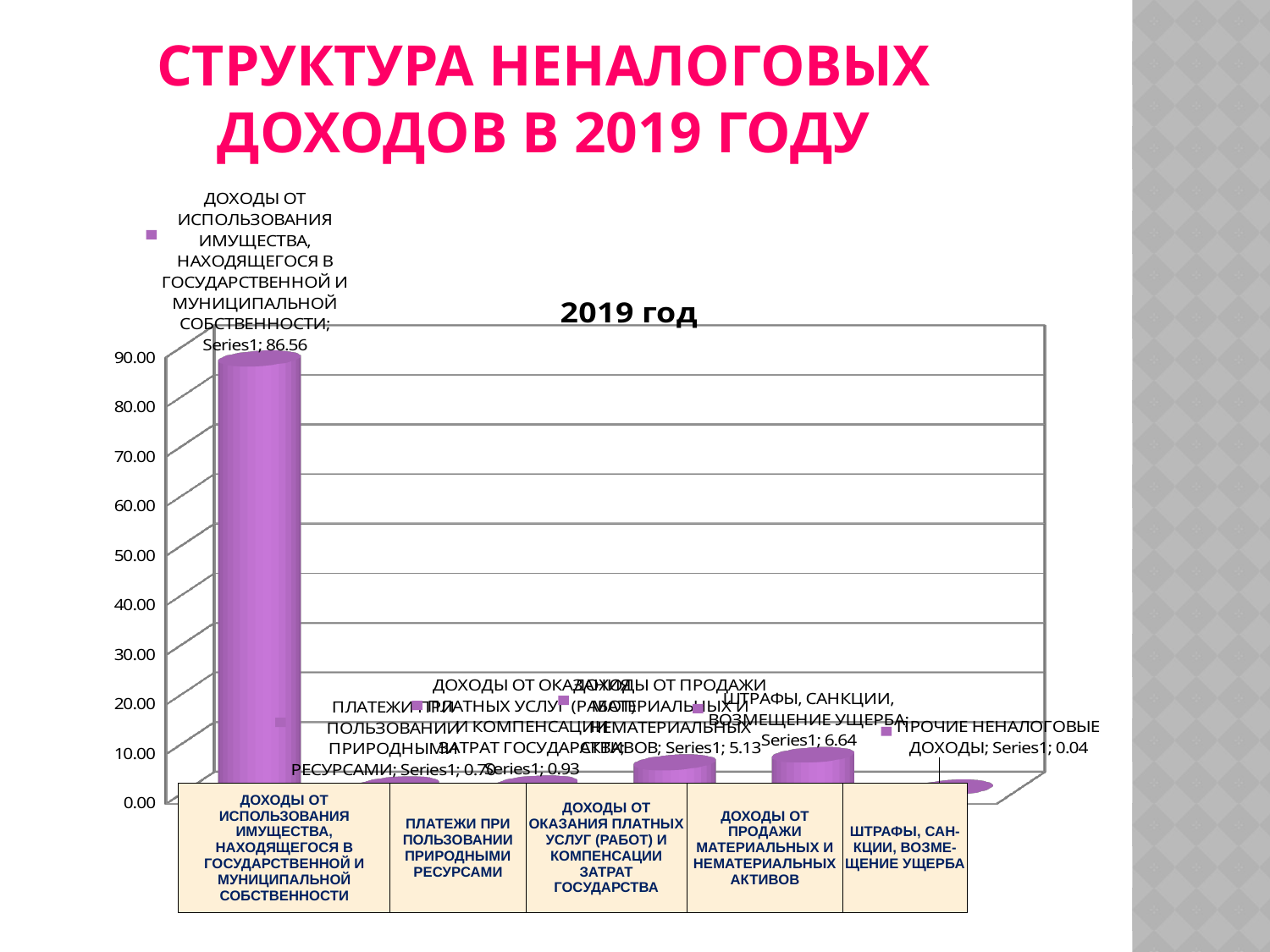
Which category has the highest value? ДОХОДЫ ОТ ИСПОЛЬЗОВАНИЯ ИМУЩЕСТВА, НАХОДЯЩЕГОСЯ В ГОСУДАРСТВЕННОЙ И МУНИЦИПАЛЬНОЙ СОБСТВЕННОСТИ What is the value for ПРОЧИЕ НЕНАЛОГОВЫЕ ДОХОДЫ? 0.04 What is the difference between the values for ШТРАФЫ, САНКЦИИ, ВОЗМЕЩЕНИЕ УЩЕРБА and ДОХОДЫ ОТ ПРОДАЖИ МАТЕРИАЛЬНЫХ И НЕМАТЕРИАЛЬНЫХ АКТИВОВ? 1.51 What kind of chart is shown on the slide? bar chart How many categories are plotted in the chart? 6 What is the value for ДОХОДЫ ОТ ИСПОЛЬЗОВАНИЯ ИМУЩЕСТВА, НАХОДЯЩЕГОСЯ В ГОСУДАРСТВЕННОЙ И МУНИЦИПАЛЬНОЙ СОБСТВЕННОСТИ? 86.56 What is the value for ДОХОДЫ ОТ ПРОДАЖИ МАТЕРИАЛЬНЫХ И НЕМАТЕРИАЛЬНЫХ АКТИВОВ? 5.13 Which category has the lowest value? ПРОЧИЕ НЕНАЛОГОВЫЕ ДОХОДЫ What is the value for ДОХОДЫ ОТ ОКАЗАНИЯ ПЛАТНЫХ УСЛУГ (РАБОТ) И КОМПЕНСАЦИИ ЗАТРАТ ГОСУДАРСТВА? 0.93 What is the value for ШТРАФЫ, САНКЦИИ, ВОЗМЕЩЕНИЕ УЩЕРБА? 6.64 Which is larger: the value for ШТРАФЫ, САНКЦИИ, ВОЗМЕЩЕНИЕ УЩЕРБА or the value for ДОХОДЫ ОТ ПРОДАЖИ МАТЕРИАЛЬНЫХ И НЕМАТЕРИАЛЬНЫХ АКТИВОВ? ШТРАФЫ, САНКЦИИ, ВОЗМЕЩЕНИЕ УЩЕРБА Is the value for ДОХОДЫ ОТ ИСПОЛЬЗОВАНИЯ ИМУЩЕСТВА, НАХОДЯЩЕГОСЯ В ГОСУДАРСТВЕННОЙ И МУНИЦИПАЛЬНОЙ СОБСТВЕННОСТИ greater or less than 80.00? greater